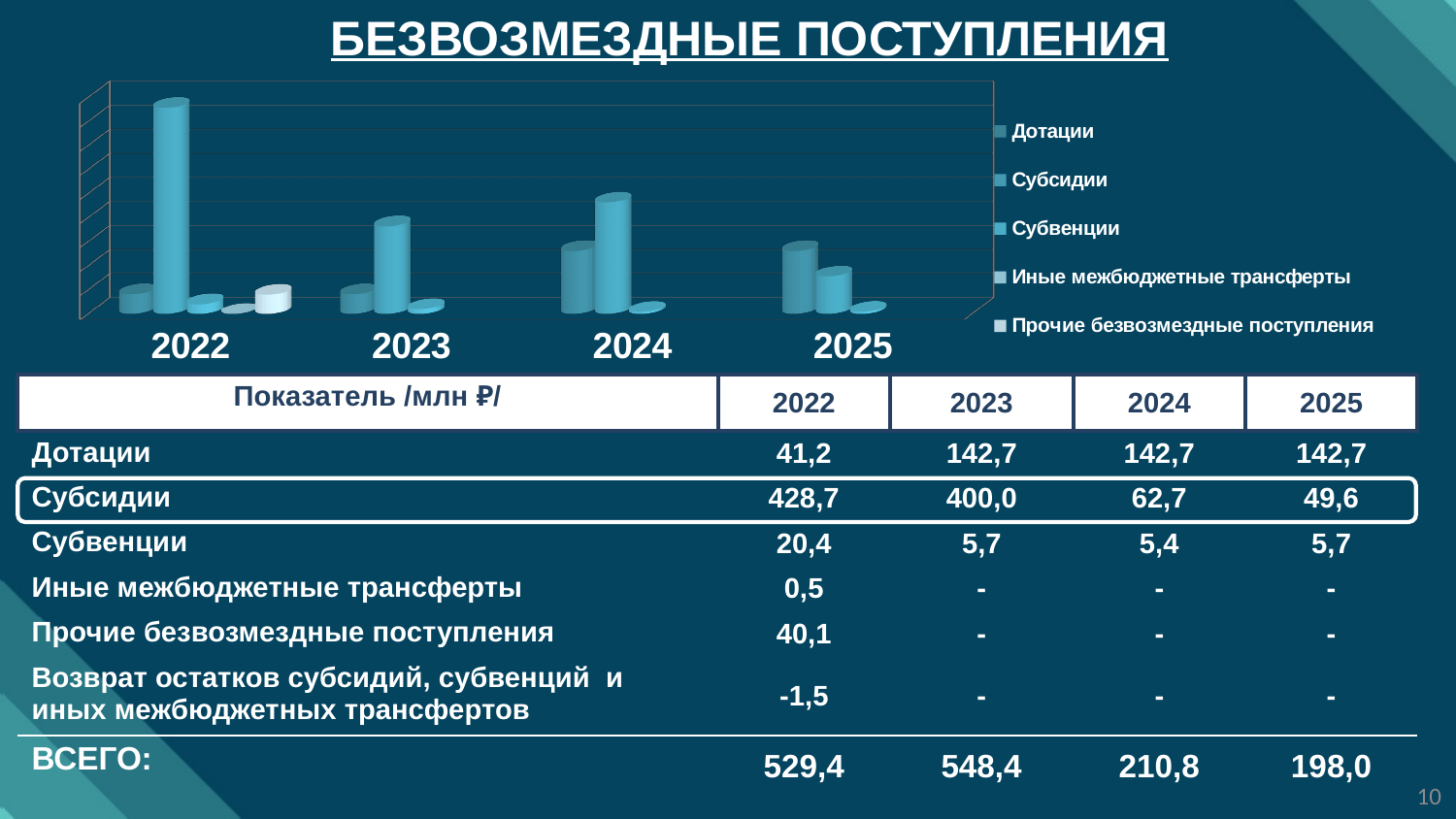
What is the title of the slide above the chart? БЕЗВОЗМЕЗДНЫЕ ПОСТУПЛЕНИЯ Do the values for Субсидии rise or fall from 2022 to 2025? fall How many series does the chart legend list? 5 Which year has the tallest bar for Субсидии? 2022 What kind of chart is shown on the slide? bar chart How many years are shown along the x axis of the chart? 4 In 2022, which is larger: Дотации or Субсидии? Субсидии What is the value of Дотации for 2022 (млн ₽)? 41,2 What is the value of Субсидии for 2023 (млн ₽)? 400,0 What is the difference between Субсидии in 2022 and Субсидии in 2025 (млн ₽)? 379,1 What is the total (ВСЕГО) for 2024 (млн ₽)? 210,8